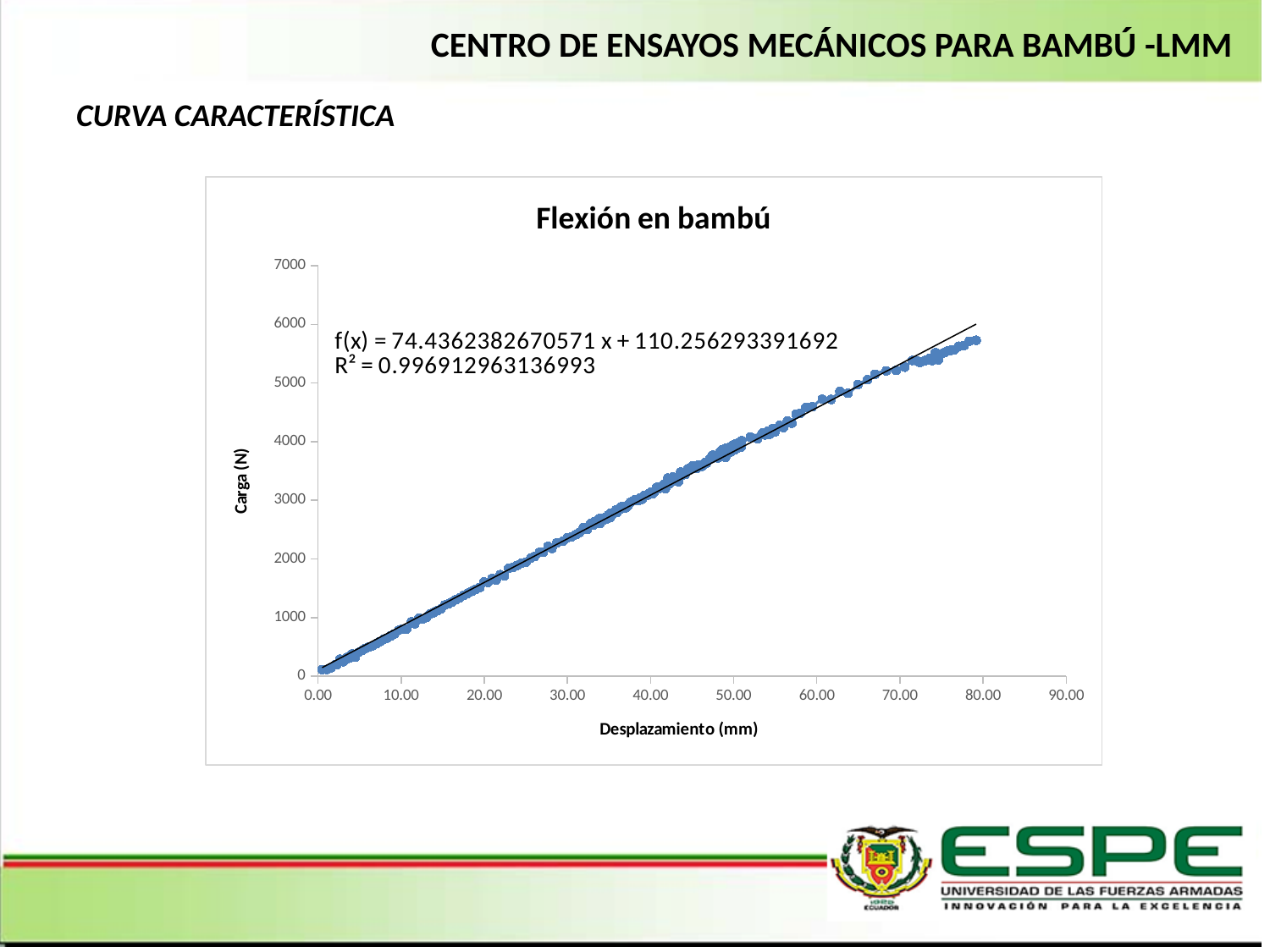
Is the load (Carga) at a displacement of 10.00 mm greater or less than 1000? less What kind of chart is shown on the slide? scatter chart What is the label of the x axis of the chart? Desplazamiento (mm) What is the title of the chart? Flexión en bambú What is the maximum value shown on the y axis of the chart? 7000 Is the load (Carga) at a displacement of 60.00 mm greater or less than 4000? greater Is the highest load reached in the chart greater or less than 6000? less What is the R² value shown on the chart? 0.996912963136993 What is the slope of the fitted line f(x) shown on the chart? 74.4362382670571 What is the intercept of the fitted line f(x) shown on the chart? 110.256293391692 Do the plotted values rise or fall as displacement increases along the x axis? rise